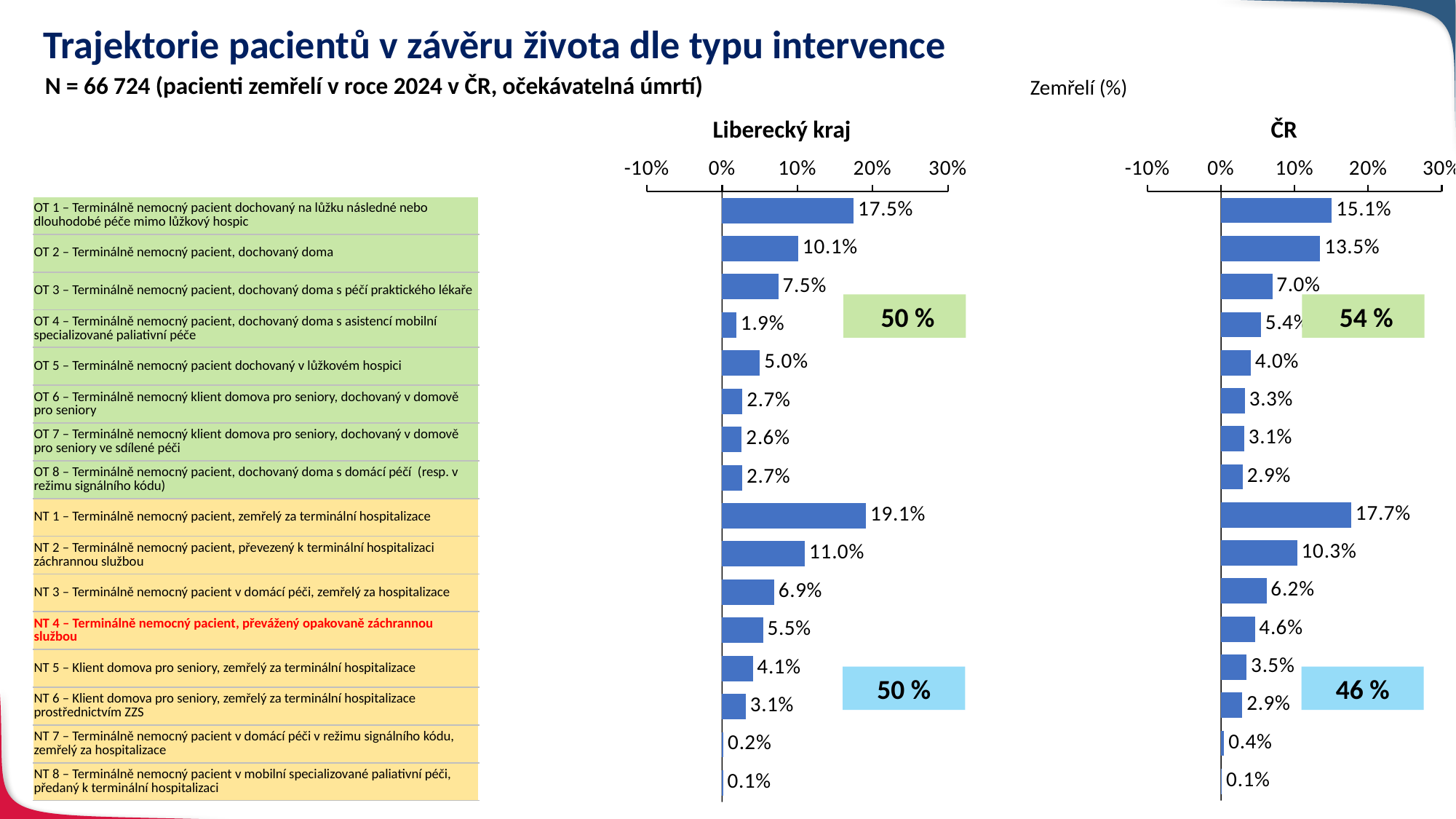
In the ČR chart, what is the value for OT 2 (Terminálně nemocný pacient, dochovaný doma)? 13.5% What percentage is shown in the green box on the ČR chart? 54 % What type of chart is the ČR chart? Bar chart In the Liberecký kraj chart, what is the difference between the values for OT 1 and OT 2? 7.4% In the ČR chart, which category has the lowest value? NT 8 In the Liberecký kraj chart, which category has the highest value? NT 1 In the ČR chart, what is the difference between the values for NT 1 and NT 2? 7.4% Which is larger: the value for OT 4 in the Liberecký kraj chart or the value for OT 4 in the ČR chart? ČR How many categories are plotted in the Liberecký kraj chart? 16 In the ČR chart, what is the value for NT 4 (převážený opakovaně záchrannou službou)? 4.6% In the Liberecký kraj chart, what is the value for OT 4 (dochovaný doma s asistencí mobilní specializované paliativní péče)? 1.9% In the Liberecký kraj chart, what is the value for NT 1 (Terminálně nemocný pacient, zemřelý za terminální hospitalizace)? 19.1%